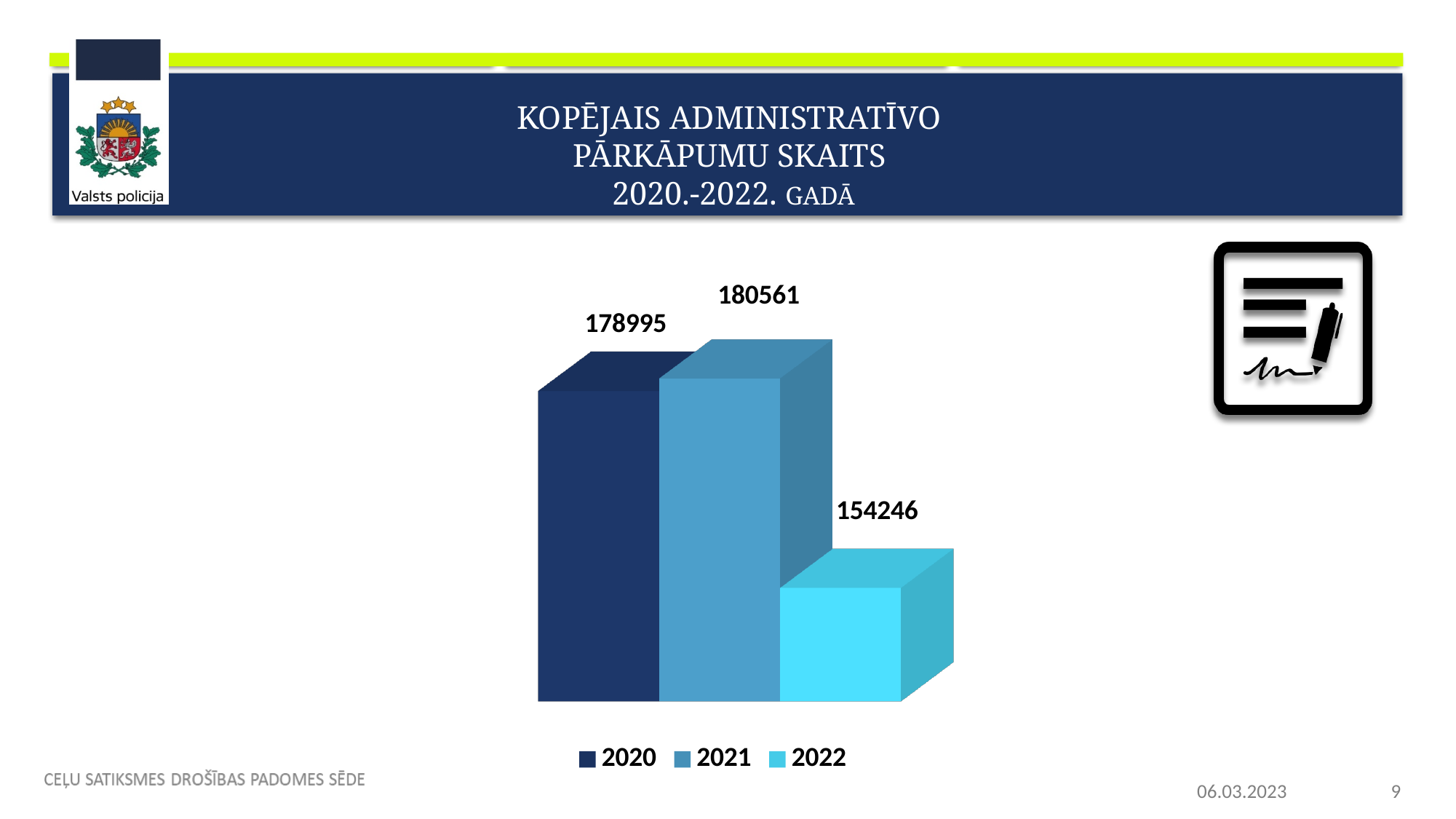
How many bars are plotted in the chart? 3 Which is larger, the value for 2020 or the value for 2022? 2020 What kind of chart is shown on the slide? Bar chart What is the value shown for 2021? 180561 What is the value shown for 2020? 178995 What is the difference between the values for 2021 and 2020? 1566 What is the value shown for 2022? 154246 How many entries does the legend list? 3 What is the difference between the values for 2020 and 2022? 24749 Which year has the lowest value? 2022 Which year has the highest value? 2021 What is the difference between the values for 2021 and 2022? 26315